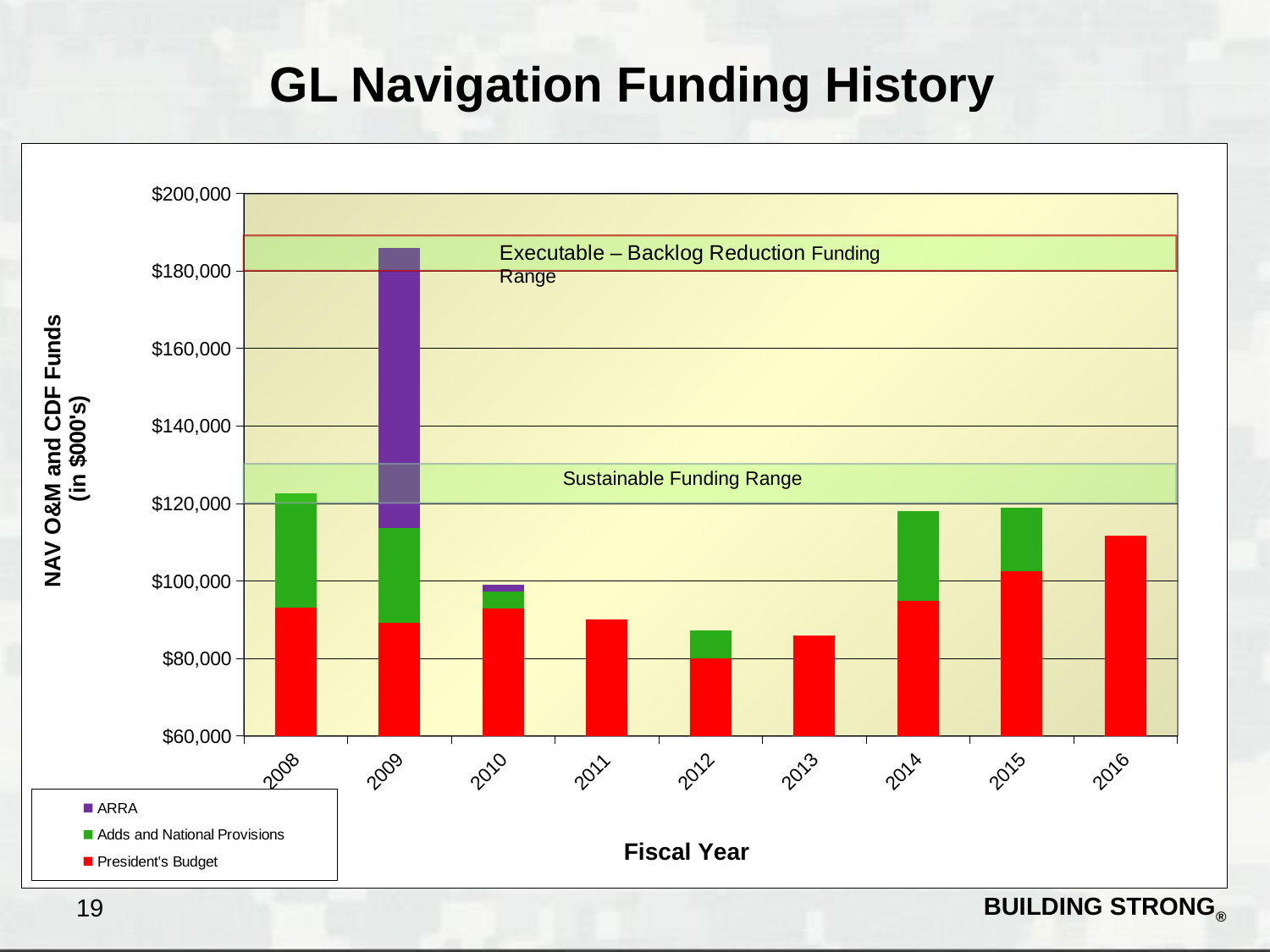
Is the total funding for 2013 greater or less than $100,000? less How many fiscal years are shown on the x axis? 9 How many series does the legend list? 3 Is the total funding for 2009 greater or less than $180,000? greater Which has the larger total funding, 2008 or 2009? 2009 What kind of chart is shown on the slide? Stacked bar chart Do total funding values rise or fall from 2009 to 2013? fall Is the total funding for 2011 greater or less than $100,000? less What is the title of the chart? GL Navigation Funding History Which series is shown in purple in the legend? ARRA Which fiscal year has the highest total funding? 2009